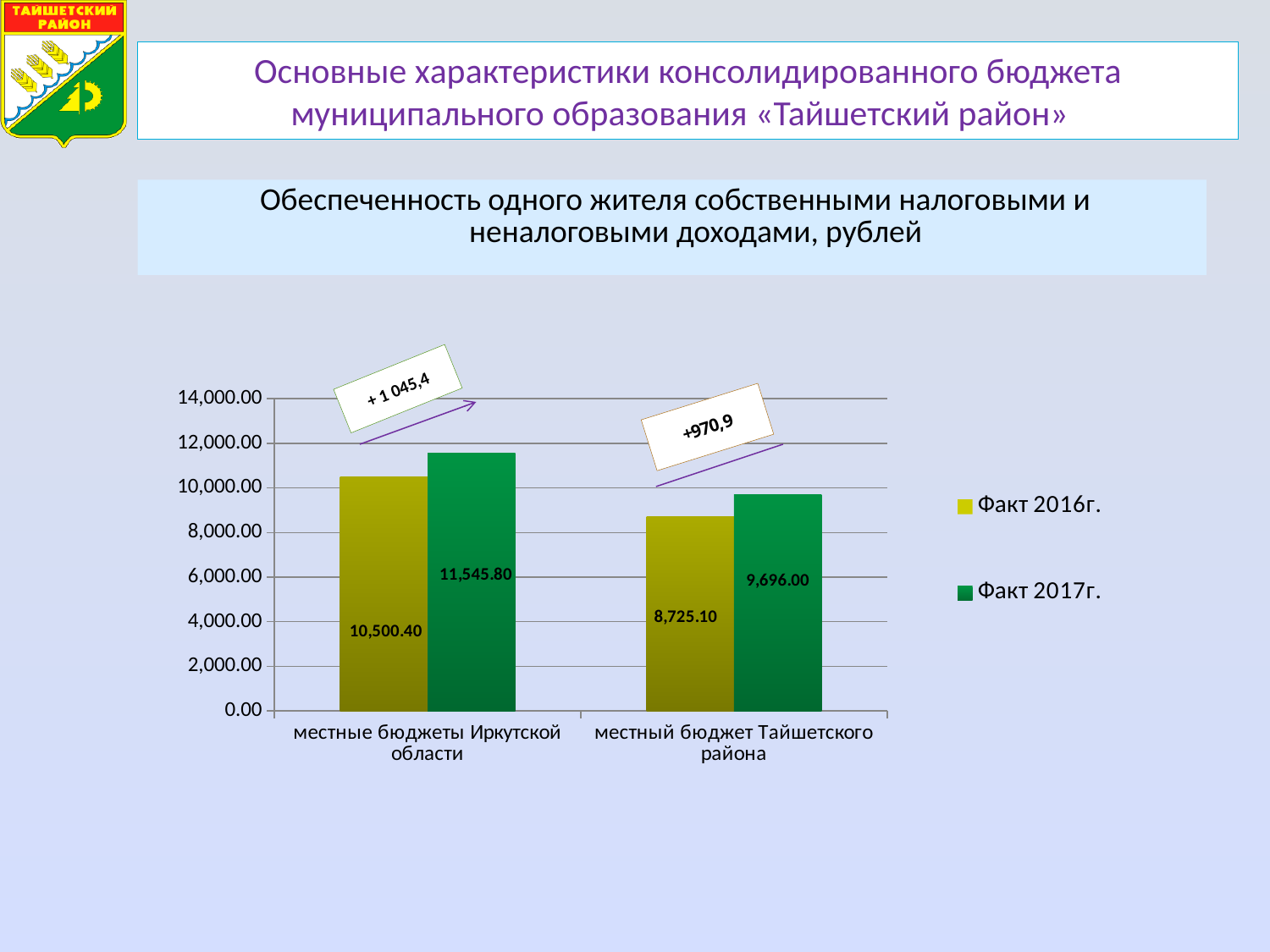
What is the value for Факт 2017г. for местный бюджет Тайшетского района? 9,696.00 What is the value for Факт 2016г. for местный бюджет Тайшетского района? 8,725.10 What is the value for Факт 2016г. for местные бюджеты Иркутской области? 10,500.40 What is the difference between the Факт 2017г. and Факт 2016г. values for местный бюджет Тайшетского района? 970.90 How many series does the legend list? 2 What is the value for Факт 2017г. for местные бюджеты Иркутской области? 11,545.80 Is the Факт 2016г. value for местный бюджет Тайшетского района greater or less than 10,000.00? less How many categories are shown on the x axis? 2 Which category has the lowest Факт 2016г. value? местный бюджет Тайшетского района What kind of chart is shown on the slide? bar chart Which is larger for местные бюджеты Иркутской области: Факт 2016г. or Факт 2017г.? Факт 2017г. Which category has the highest Факт 2017г. value? местные бюджеты Иркутской области